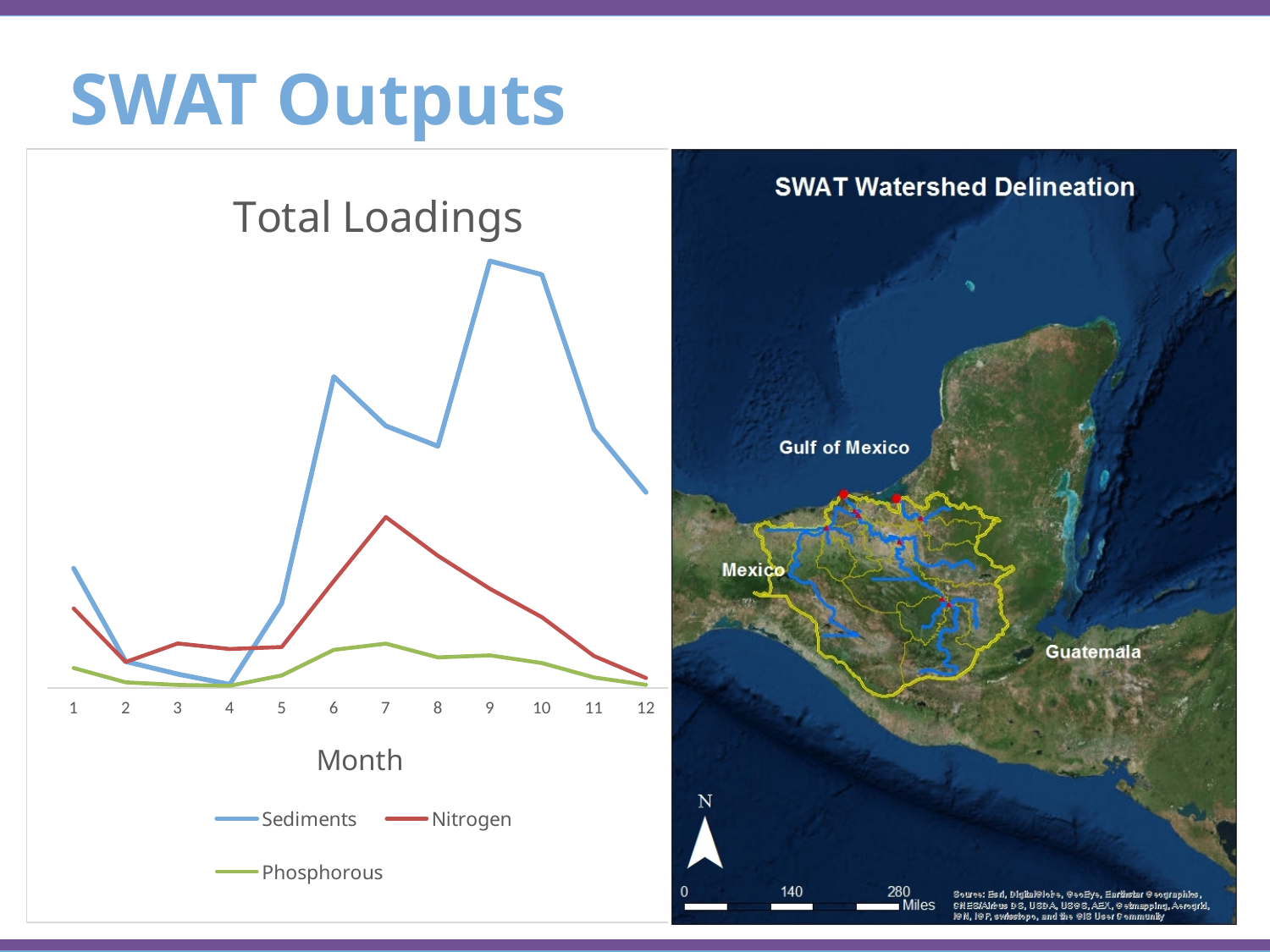
In which month is the Sediments series at its lowest in the Total Loadings chart? 4 What kind of chart is the Total Loadings chart? line chart Does the Sediments series rise or fall from month 9 to month 12 in the Total Loadings chart? fall In month 7 of the Total Loadings chart, which series has the larger value, Nitrogen or Phosphorous? Nitrogen What is the title of the line chart on the slide? Total Loadings How many months are plotted along the x axis of the Total Loadings chart? 12 In month 9 of the Total Loadings chart, which series has the larger value, Sediments or Nitrogen? Sediments Which series has the highest value overall in the Total Loadings chart? Sediments How many series does the legend of the Total Loadings chart list? 3 In which month does the Nitrogen series reach its highest value in the Total Loadings chart? 7 In which month does the Sediments series reach its highest value in the Total Loadings chart? 9 What is the x-axis label of the Total Loadings chart? Month